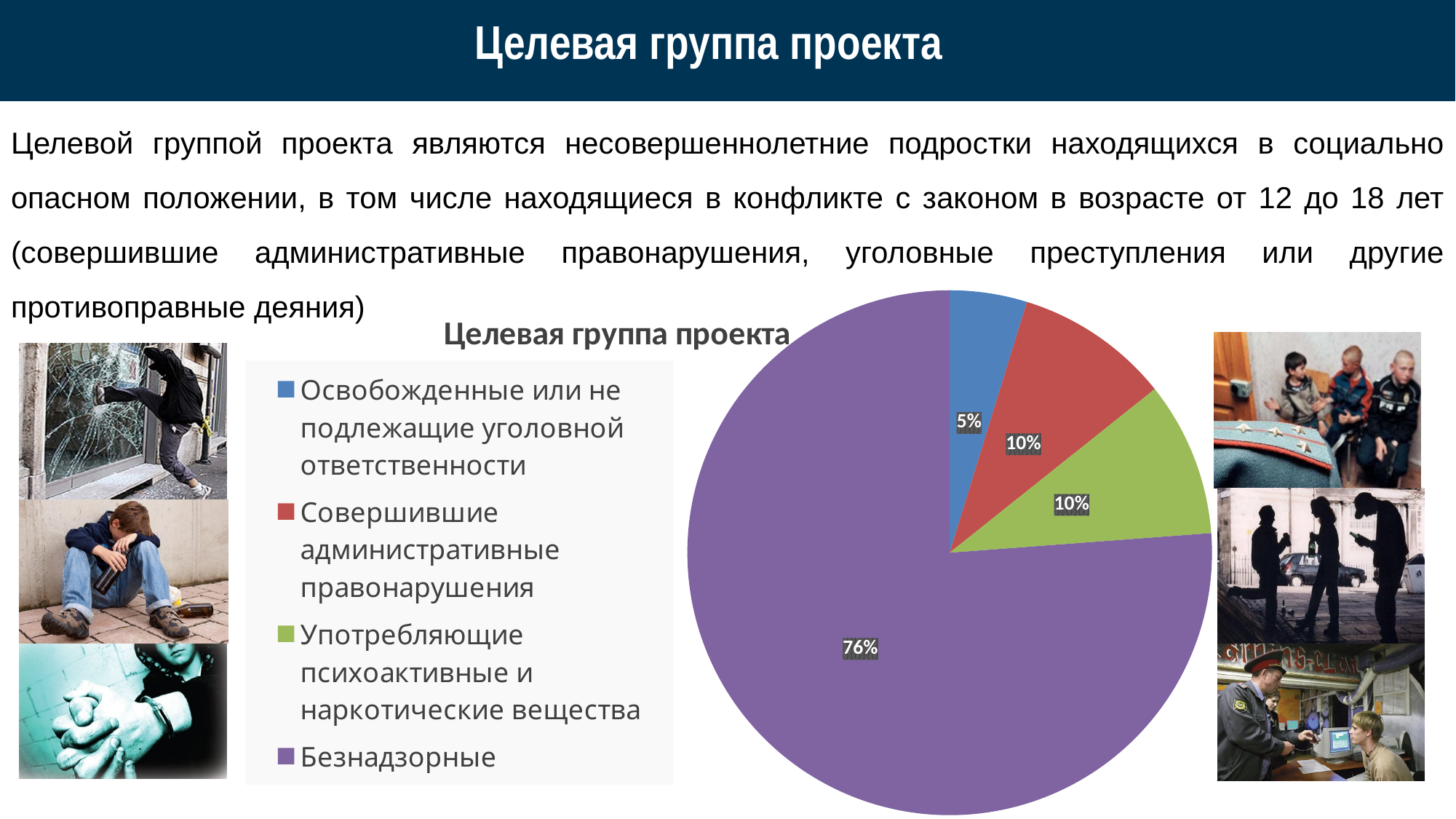
What share of the pie is labelled "Освобожденные или не подлежащие уголовной ответственности"? 5% Which is larger: the slice for "Совершившие административные правонарушения" or the slice for "Освобожденные или не подлежащие уголовной ответственности"? Совершившие административные правонарушения What is the title of the chart? Целевая группа проекта What share of the pie is labelled "Употребляющие психоактивные и наркотические вещества"? 10% Which category has the smallest slice of the pie? Освобожденные или не подлежащие уголовной ответственности Which category has the largest slice of the pie? Безнадзорные What kind of chart is shown on the slide? pie chart How many categories does the pie chart have? 4 What share of the pie is labelled "Совершившие административные правонарушения"? 10% What colour is the slice for "Безнадзорные"? purple What is the difference in percentage points between the "Безнадзорные" slice and the "Совершившие административные правонарушения" slice? 66